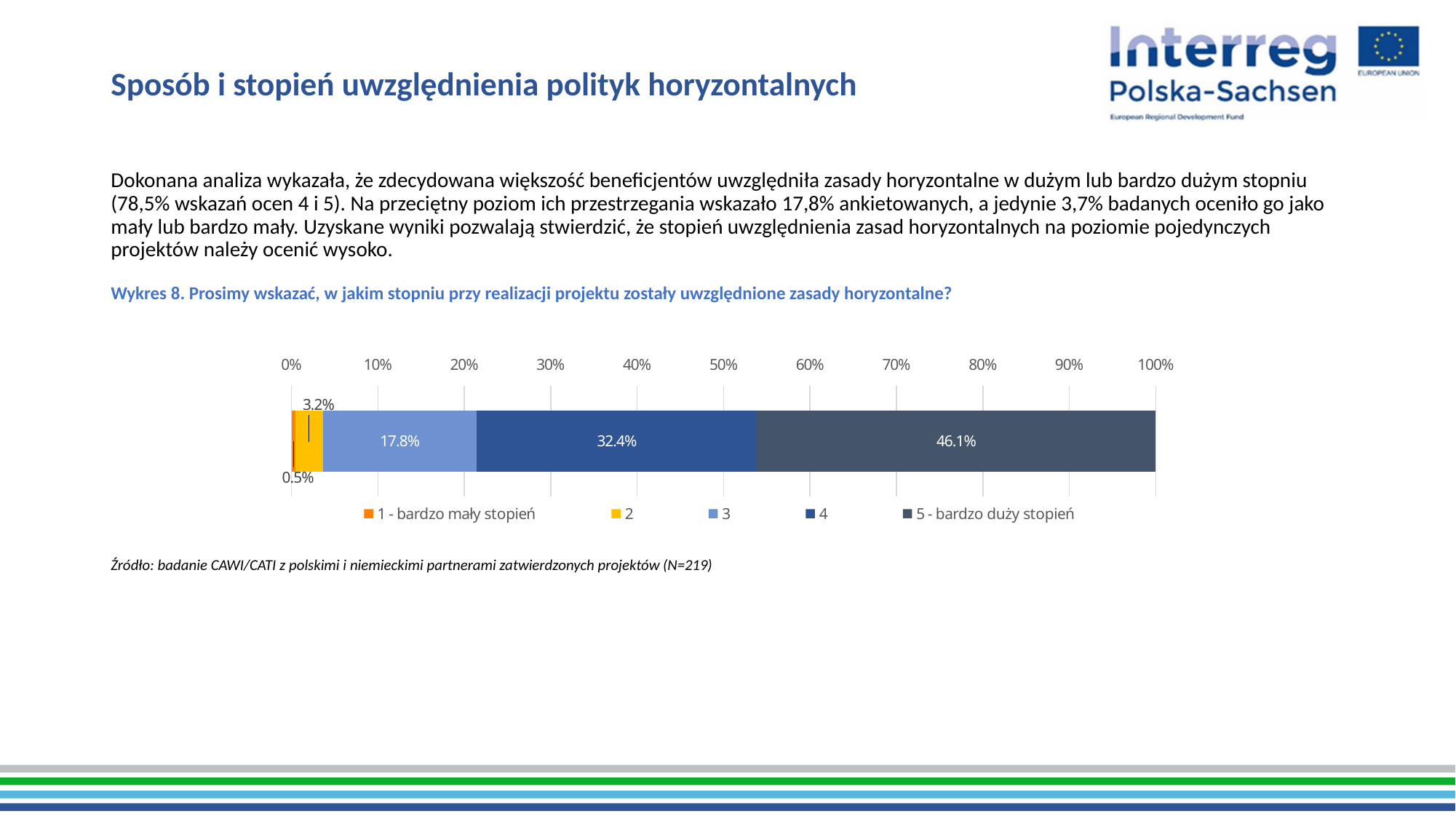
What is the total of the stacked bar? 100.0% Which series has the lowest value? 1 - bardzo mały stopień What is the value for the series "1 - bardzo mały stopień"? 0.5% Which series has the highest value? 5 - bardzo duży stopień What is the difference between the values for series "5 - bardzo duży stopień" and series "4"? 13.7% What kind of chart is shown on the slide? Stacked bar chart What is the value for the series "3"? 17.8% How many series does the legend list? 5 What is the value for the series "4"? 32.4% Which is larger, the value for series "3" or the value for series "4"? 4 What is the value for the series "5 - bardzo duży stopień"? 46.1% What is the value for the series "2"? 3.2%